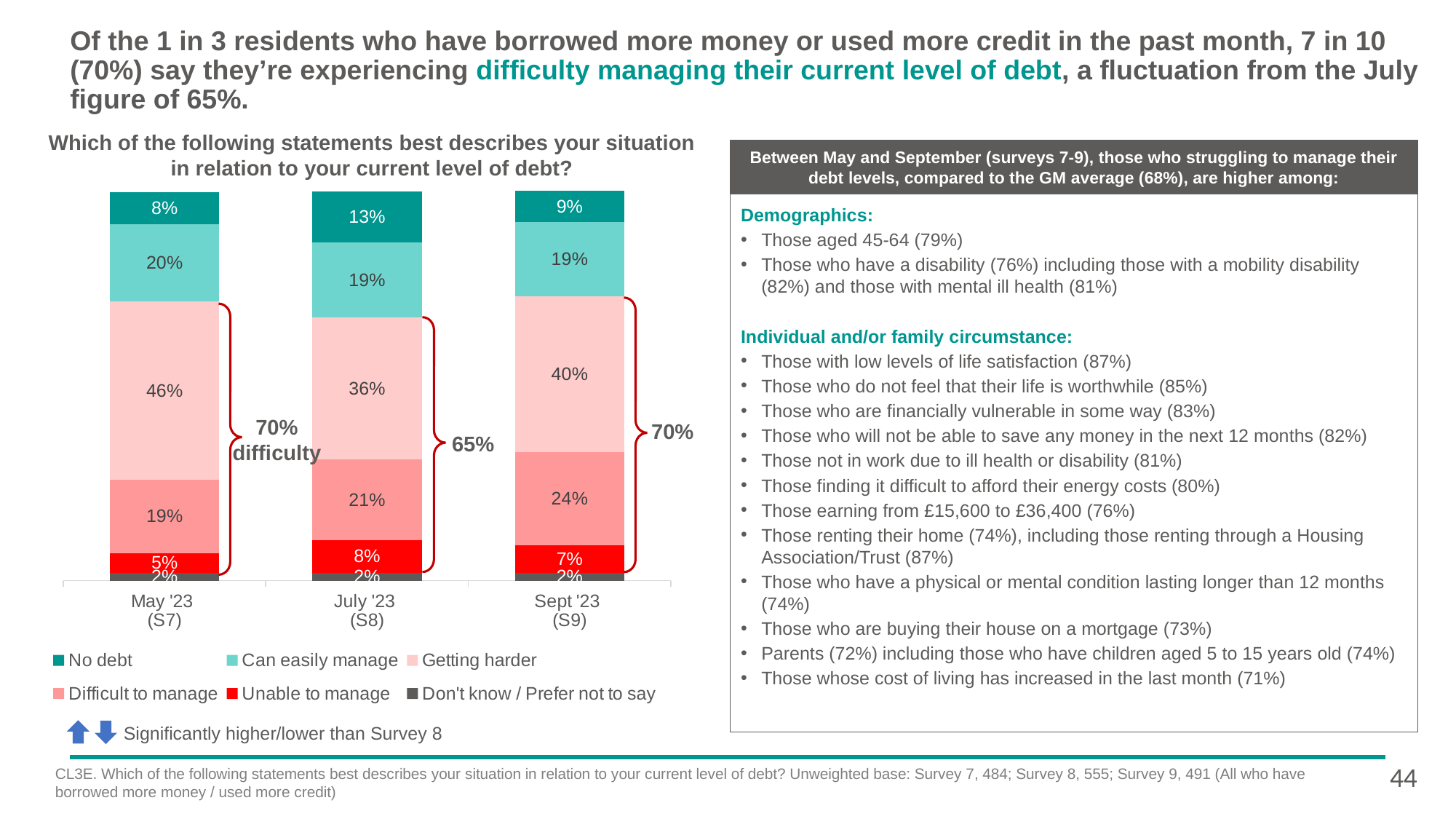
What combined 'difficulty' percentage is marked by the bracket for July '23 (S8)? 65% What is the 'No debt' value for July '23 (S8)? 13% In which survey wave is the 'Getting harder' value highest? May '23 (S7) What is the difference between the 'Difficult to manage' values for Sept '23 (S9) and May '23 (S7)? 5% How many survey waves (bars) are shown on the x axis? 3 Which is larger: the 'Can easily manage' value for May '23 (S7) or for July '23 (S8)? May '23 (S7) In which survey wave is the 'No debt' value lowest? May '23 (S7) What is the 'Difficult to manage' value for Sept '23 (S9)? 24% What kind of chart is shown on the slide? stacked bar chart How many series does the chart legend list? 6 What is the 'Getting harder' value for May '23 (S7)? 46% What is the 'Unable to manage' value for July '23 (S8)? 8%